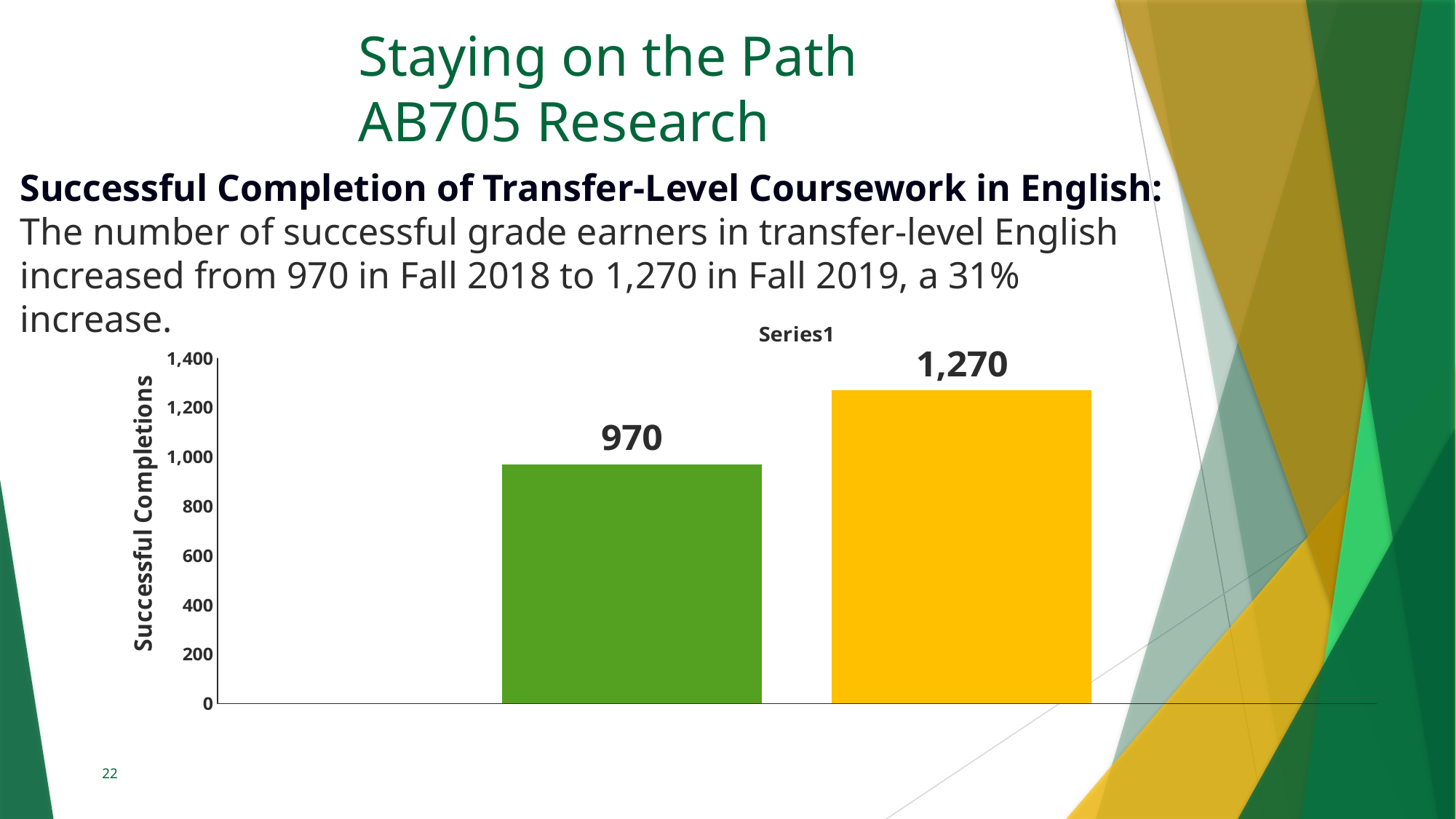
What is the highest tick value shown on the vertical axis of the chart? 1,400 What is the label on the vertical axis of the chart? Successful Completions How many bars are plotted in the chart? 2 What is the difference between the values of the yellow bar and the green bar in the chart? 300 Is the value of the green bar greater or less than 1,000? less What value is shown on the yellow (right) bar of the chart? 1,270 Is the value of the green bar larger or smaller than the value of the yellow bar? smaller What kind of chart is shown on the slide? bar chart What value is shown on the green (left) bar of the chart? 970 Which bar in the chart has the highest value, the green bar or the yellow bar? the yellow bar Is the value of the yellow bar greater or less than 1,200? greater Which bar in the chart has the lowest value, the green bar or the yellow bar? the green bar